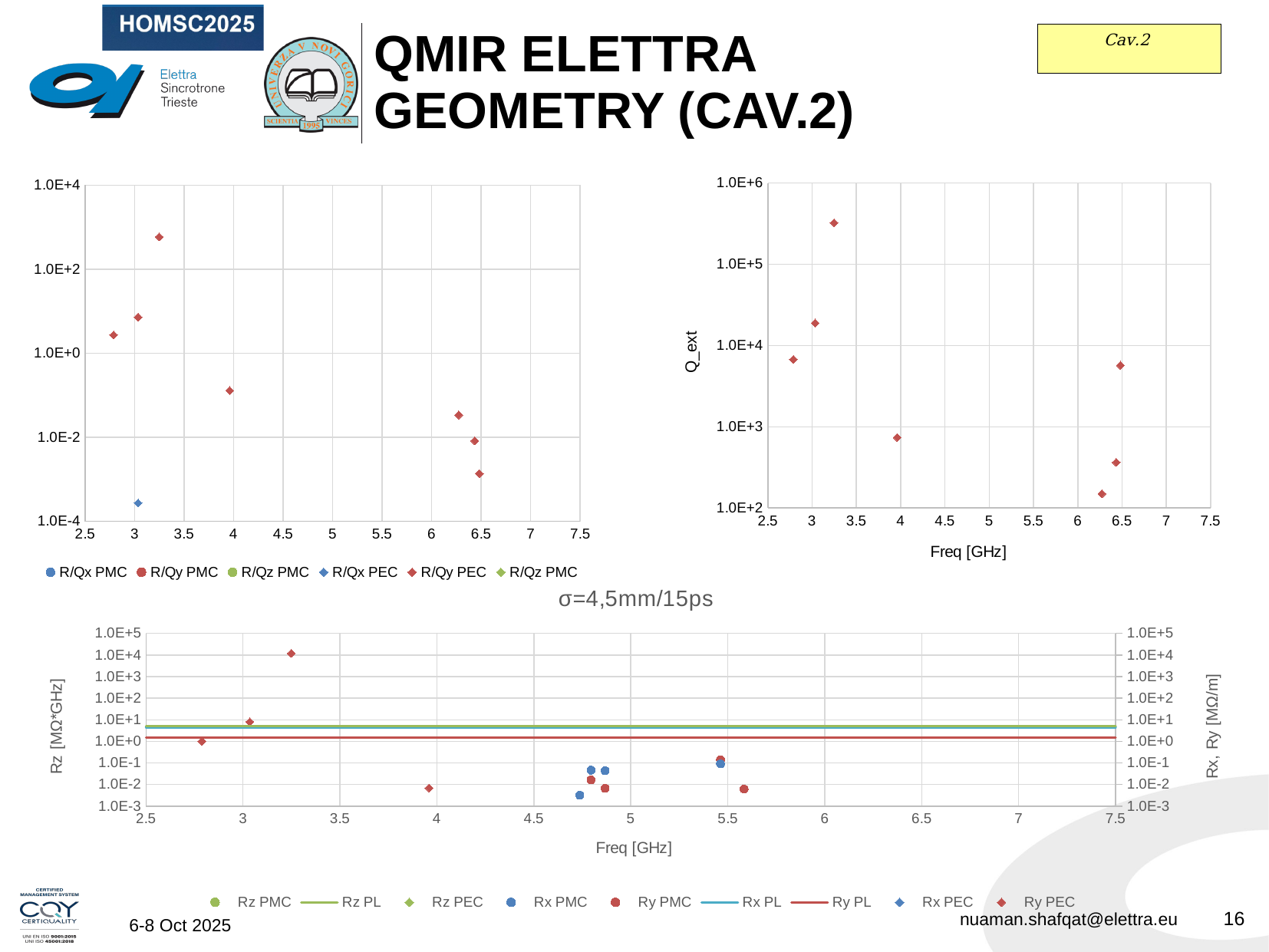
In the top-right chart, which point has the larger Q_ext: the one near 2.8 GHz or the one near 3.05 GHz? the one near 3.05 GHz In the top-left chart, is the value of the blue R/Qx PEC point near 3 GHz greater or less than 1.0E-2? less What kind of chart is the top-right chart? scatter chart In the top-right chart, is the Q_ext value of the point near 4 GHz greater or less than 1.0E+3? less In the top-right chart, what is the label on the x axis? Freq [GHz] In the top-right chart, how many data points are plotted? 7 In the top-right chart, what is the label on the y axis? Q_ext How many series does the legend of the top-left chart list? 6 In the top-right chart, is the Q_ext value of the point near 3.25 GHz greater or less than 1.0E+5? greater How many series does the legend of the bottom chart (σ=4,5mm/15ps) list? 9